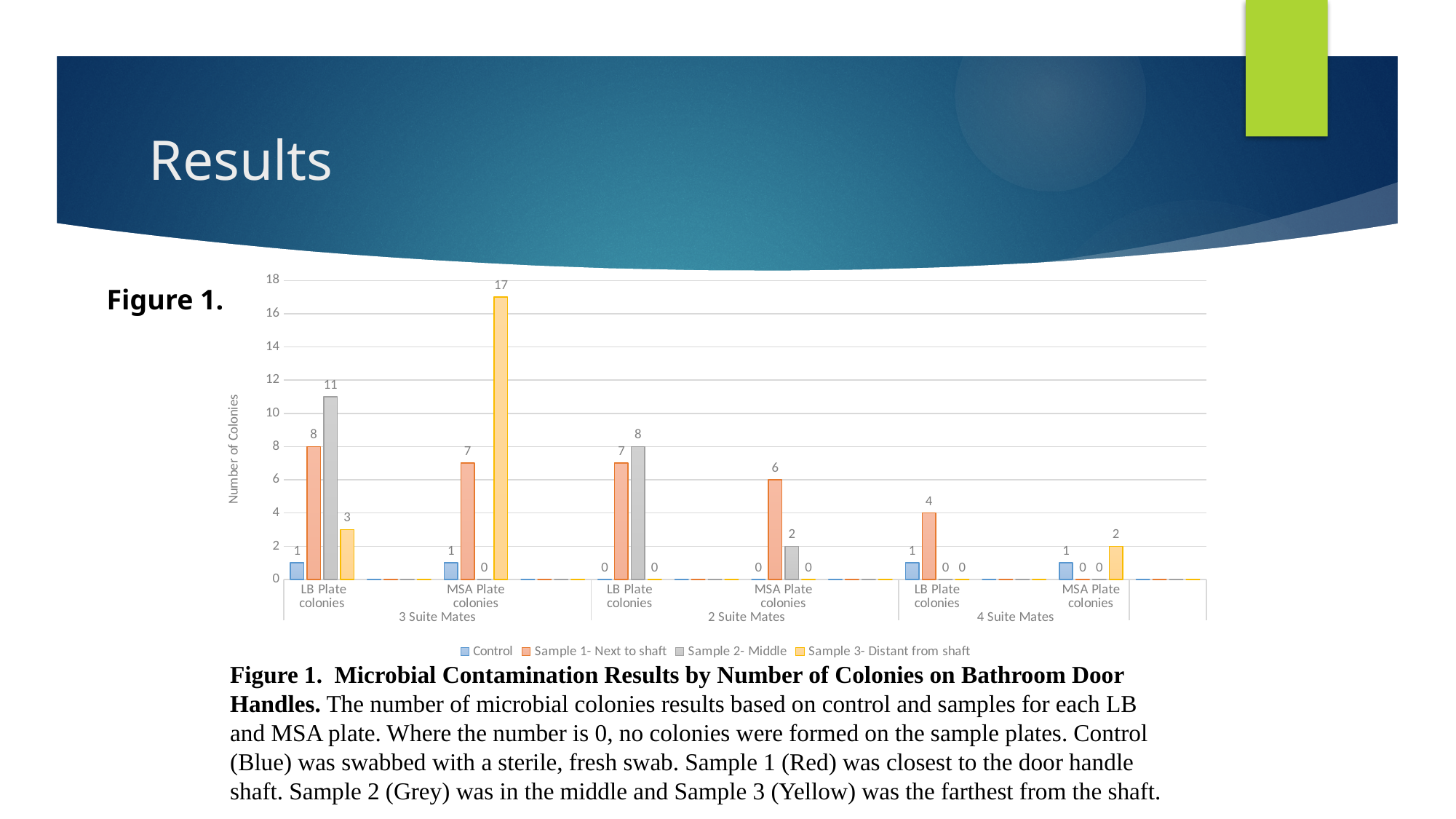
Which is larger for LB Plate colonies in the 2 Suite Mates group: Sample 1- Next to shaft or Sample 2- Middle? Sample 2- Middle What is the difference between the Sample 2- Middle and Sample 1- Next to shaft values for LB Plate colonies in the 3 Suite Mates group? 3 What is the value for Sample 1- Next to shaft for MSA Plate colonies in the 2 Suite Mates group? 6 Which series has the highest value for MSA Plate colonies in the 3 Suite Mates group? Sample 3- Distant from shaft What type of chart is shown in Figure 1? bar chart What is the value for Sample 3- Distant from shaft for MSA Plate colonies in the 3 Suite Mates group? 17 What is the value for Sample 3- Distant from shaft for MSA Plate colonies in the 4 Suite Mates group? 2 What is the value for Control for LB Plate colonies in the 2 Suite Mates group? 0 How many series does the legend of the chart list? 4 What is the value for Sample 1- Next to shaft for LB Plate colonies in the 4 Suite Mates group? 4 What is the label of the y axis of the chart? Number of Colonies What is the value for Sample 2- Middle for LB Plate colonies in the 3 Suite Mates group? 11